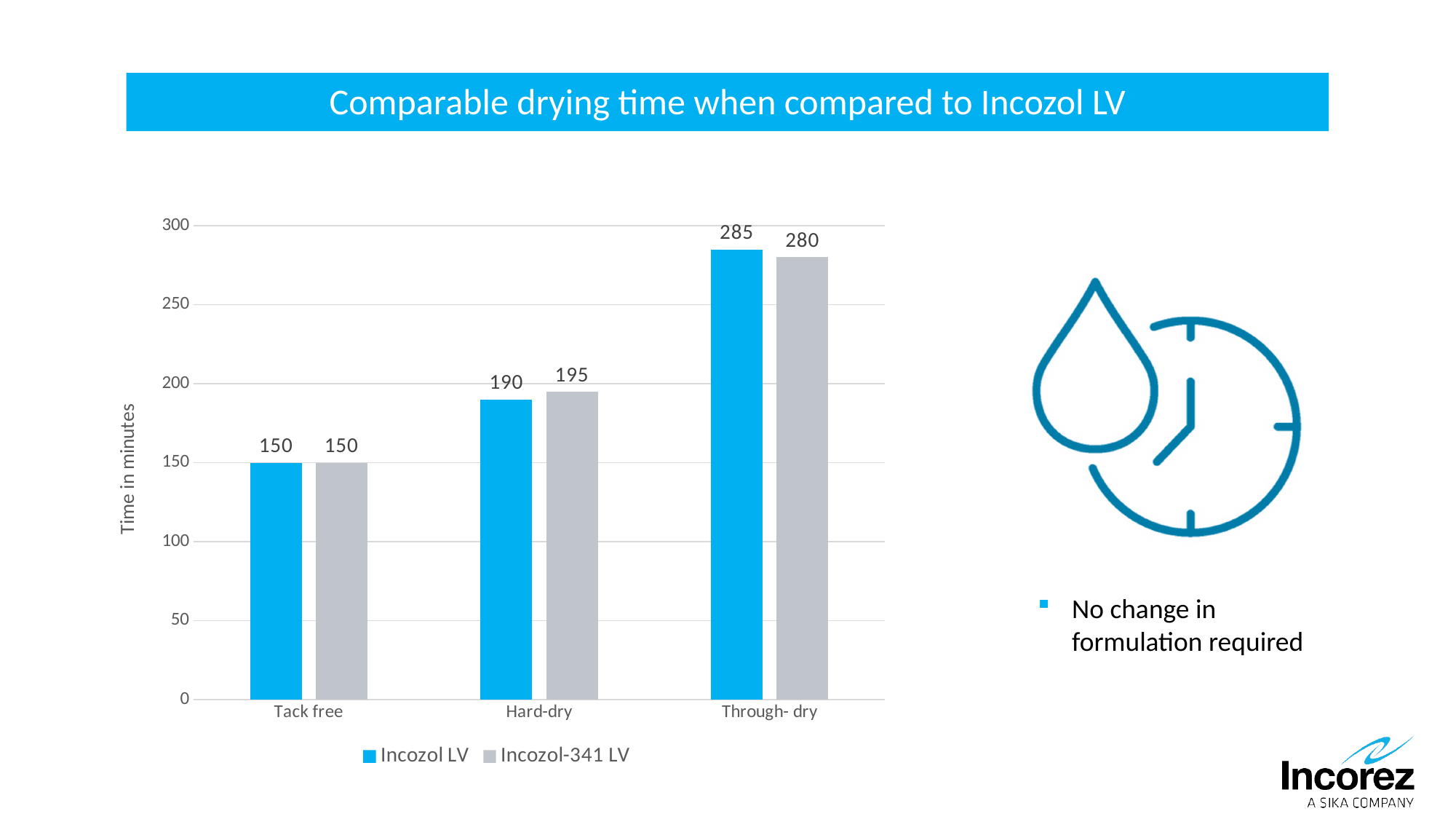
What is the difference between the Through- dry times of Incozol LV and Incozol-341 LV? 5 What is the Through- dry time for Incozol-341 LV? 280 How many series does the legend list? 2 What kind of chart is shown on the slide? Bar chart What is the difference between the Hard-dry and Tack free times for Incozol LV? 40 What is the label of the vertical axis? Time in minutes How many categories are shown on the x axis? 3 Which category has the lowest value for Incozol-341 LV? Tack free What is the Tack free time for Incozol-341 LV? 150 For Hard-dry, which series has the larger value, Incozol LV or Incozol-341 LV? Incozol-341 LV Which category has the highest value for Incozol LV? Through- dry What is the Hard-dry time for Incozol LV? 190